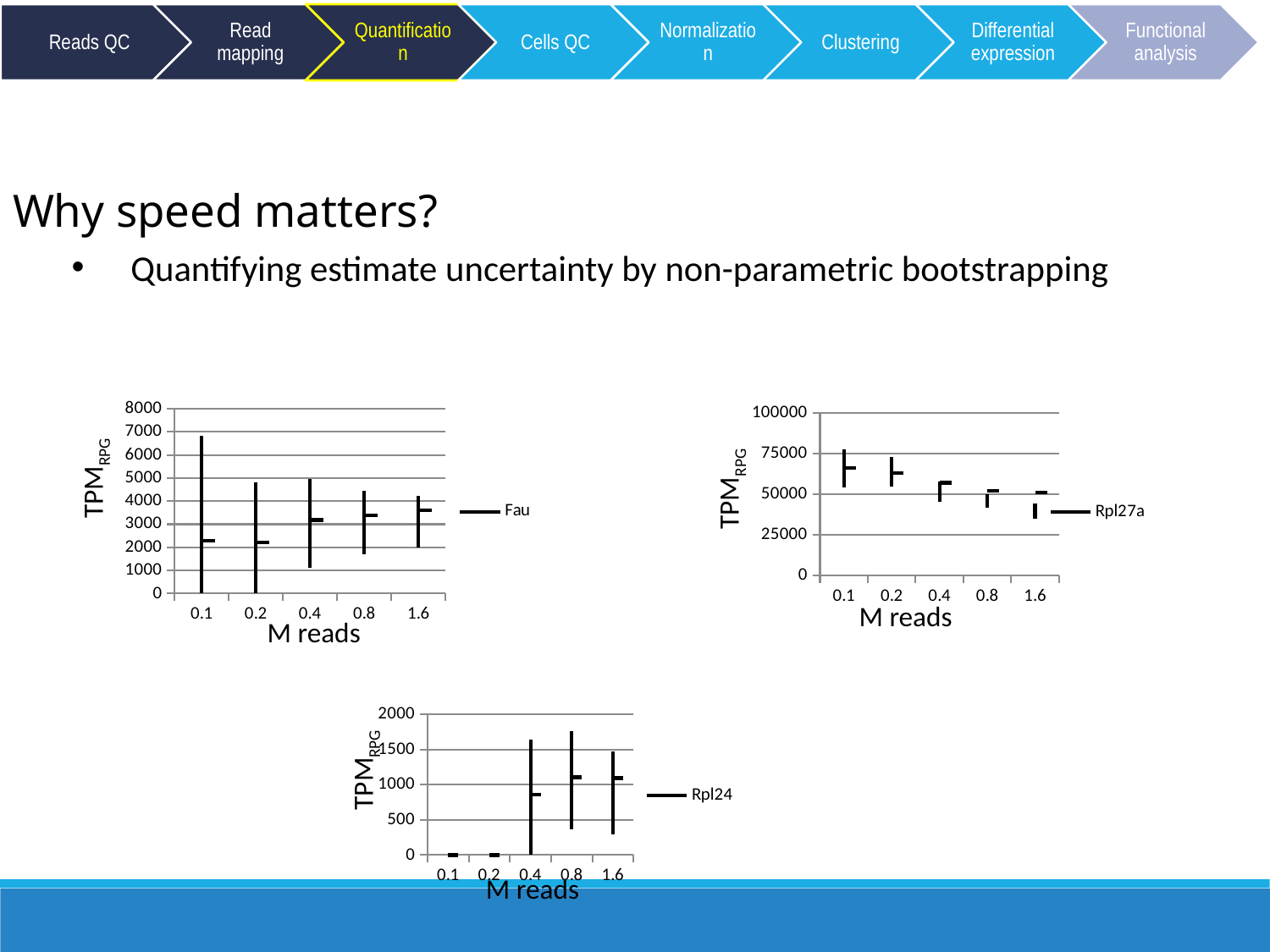
In the Fau chart, how many M reads categories are shown on the x axis? 5 In the Fau chart, is the value for 1.6 M reads greater or less than 3000? greater In the Rpl27a chart, which is larger, the value for 0.1 M reads or the value for 1.6 M reads? 0.1 In the Rpl27a chart, do the values rise or fall as M reads increases along the x axis? fall In the Rpl27a chart, is the value for 0.1 M reads greater or less than 50000? greater What is the y-axis label of the Fau chart? TPMRPG What is the legend entry of the bottom chart? Rpl24 In the Rpl24 chart, is the value for 0.8 M reads greater or less than 500? greater In the Rpl27a chart, how many series does the legend list? 1 In the Fau chart, which is larger, the value for 0.1 M reads or the value for 0.4 M reads? 0.4